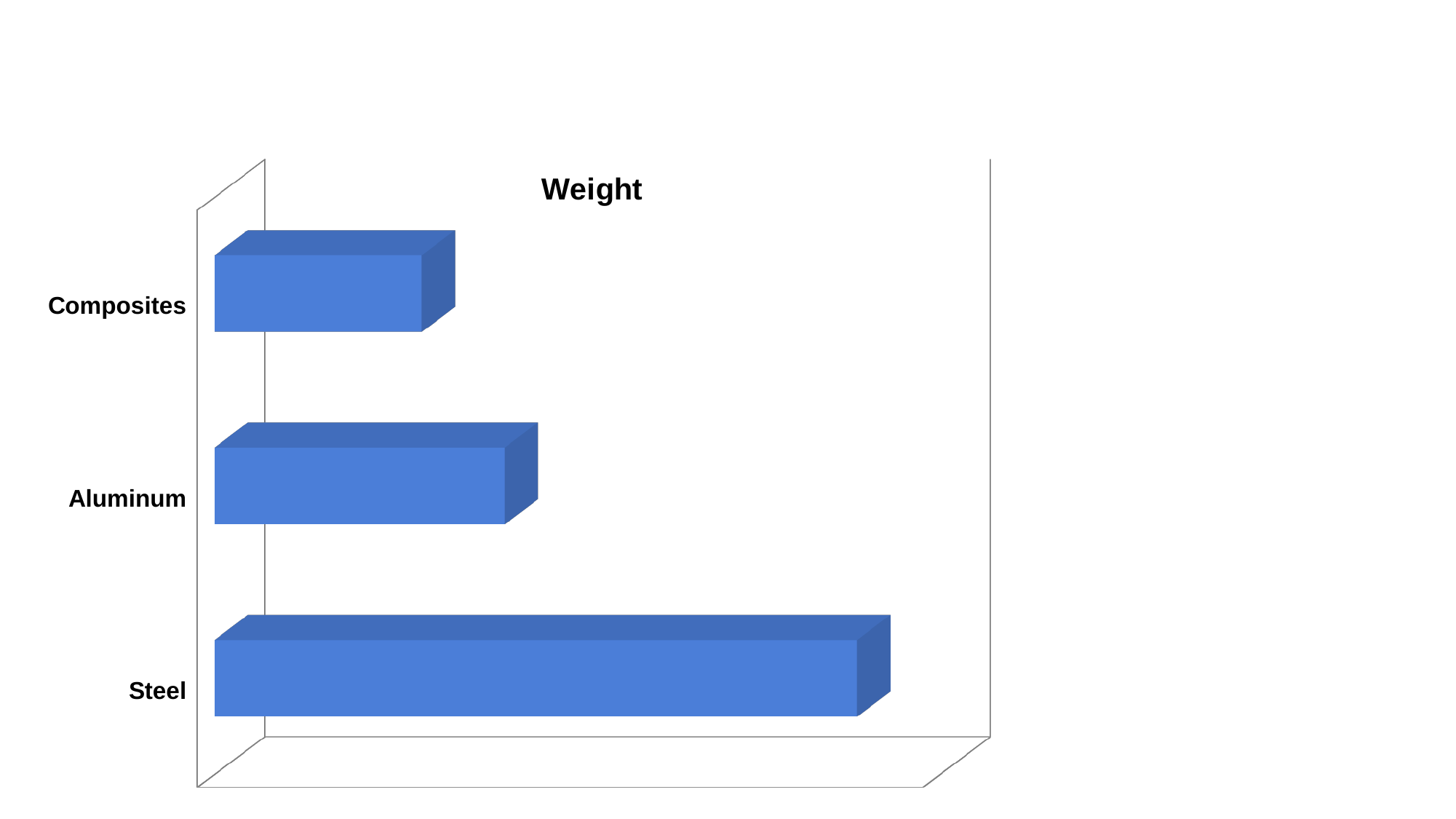
Which category is listed at the top of the chart? Composites Which category has the lowest value in the chart? Composites What is the title of the chart? Weight How many categories are plotted in the chart? 3 Which has the larger value, Aluminum or Composites? Aluminum Which has the larger value, Steel or Aluminum? Steel Which category has the highest value in the chart? Steel What kind of chart is shown on the slide? bar chart